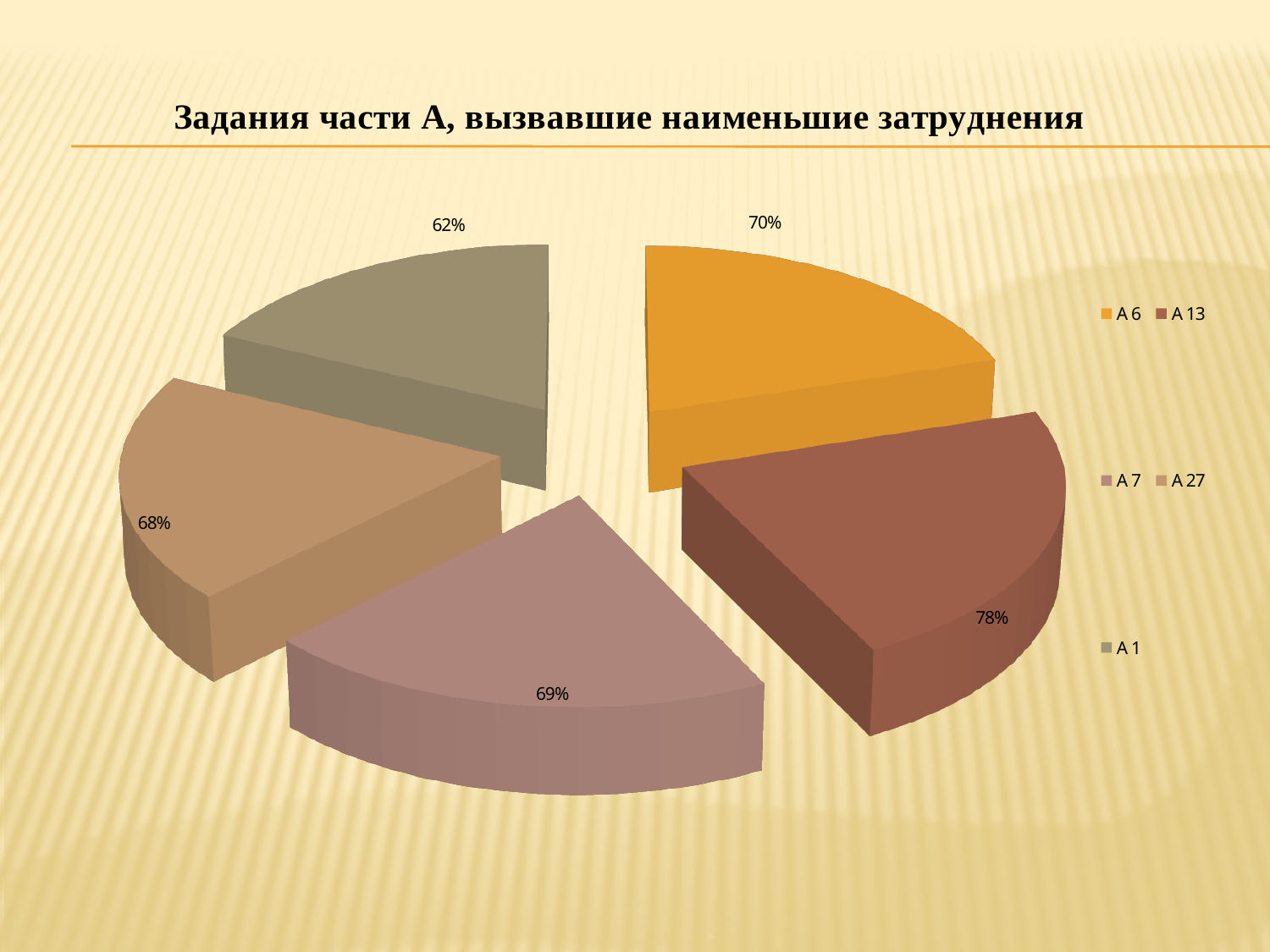
What value is shown for A 1? 62% What value is shown for A 7? 69% What value is shown for A 6? 70% Which category has the highest value? A 13 Which category has the lowest value? A 1 What is the title of the chart? Задания части А, вызвавшие наименьшие затруднения What kind of chart is shown on the slide? pie chart What value is shown for A 13? 78% What value is shown for A 27? 68% Which has a larger value, A 6 or A 27? A 6 How many entries does the legend list? 5 What is the difference between the values for A 13 and A 1? 16%